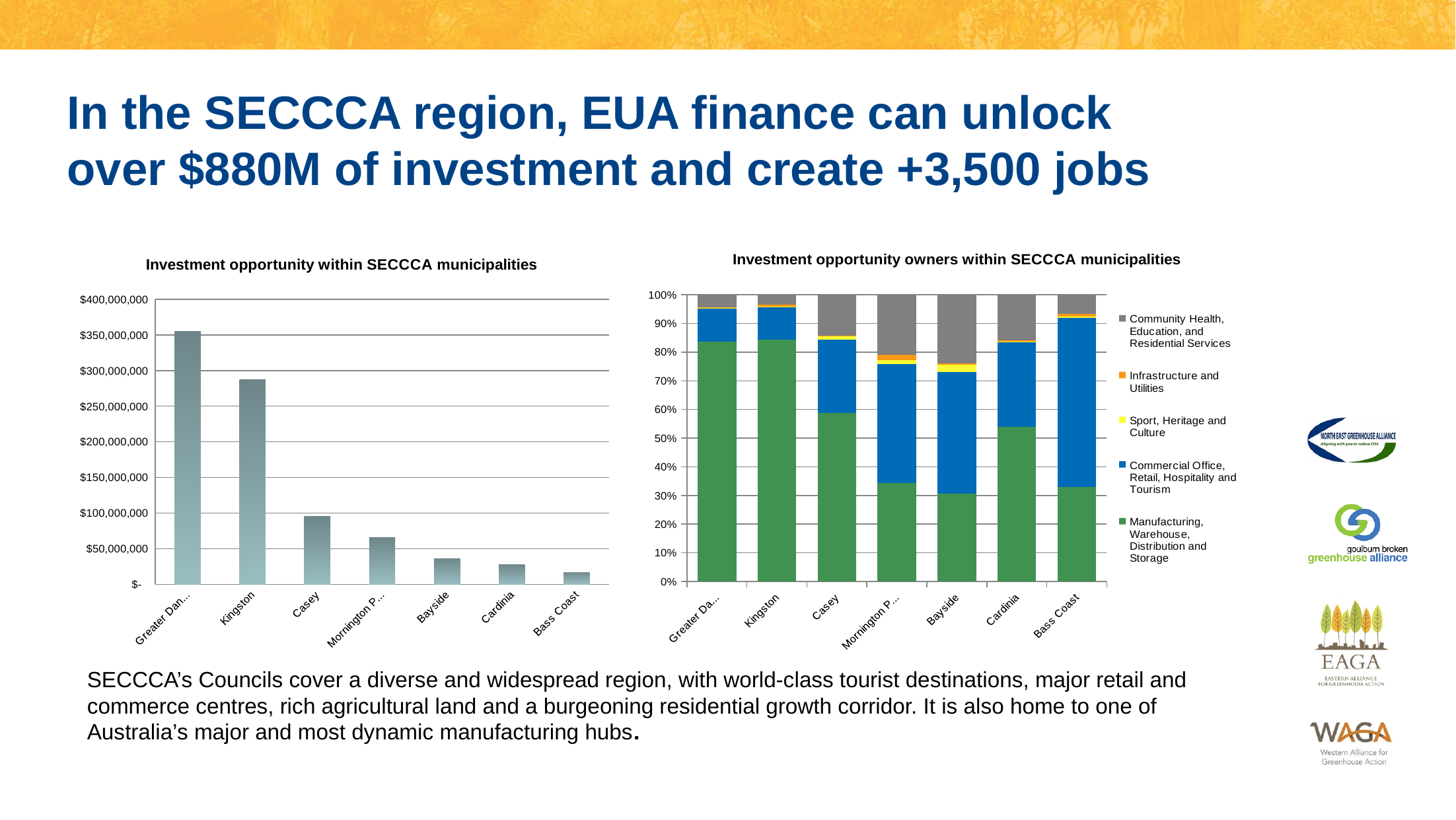
In the 'Investment opportunity within SECCCA municipalities' chart, which municipality has the lowest investment opportunity? Bass Coast What kind of chart is 'Investment opportunity within SECCCA municipalities'? bar chart In the 'Investment opportunity owners within SECCCA municipalities' chart, which colour represents Community Health, Education, and Residential Services? grey In the 'Investment opportunity within SECCCA municipalities' chart, do the values rise or fall from left to right along the x axis? fall How many series does the legend of the 'Investment opportunity owners within SECCCA municipalities' chart list? 5 In the 'Investment opportunity owners within SECCCA municipalities' chart, which municipality has the largest Commercial Office, Retail, Hospitality and Tourism share? Bass Coast In the 'Investment opportunity within SECCCA municipalities' chart, which municipality has the highest investment opportunity? Greater Dan... In the 'Investment opportunity owners within SECCCA municipalities' chart, is the Manufacturing, Warehouse, Distribution and Storage share for Kingston greater or less than 80%? greater How many municipalities are shown in the 'Investment opportunity within SECCCA municipalities' chart? 7 In the 'Investment opportunity within SECCCA municipalities' chart, which is larger, the value for Kingston or the value for Casey? Kingston In the 'Investment opportunity within SECCCA municipalities' chart, is the value for Bayside greater or less than $50,000,000? less In the 'Investment opportunity within SECCCA municipalities' chart, is the value for Greater Dan... greater or less than $300,000,000? greater